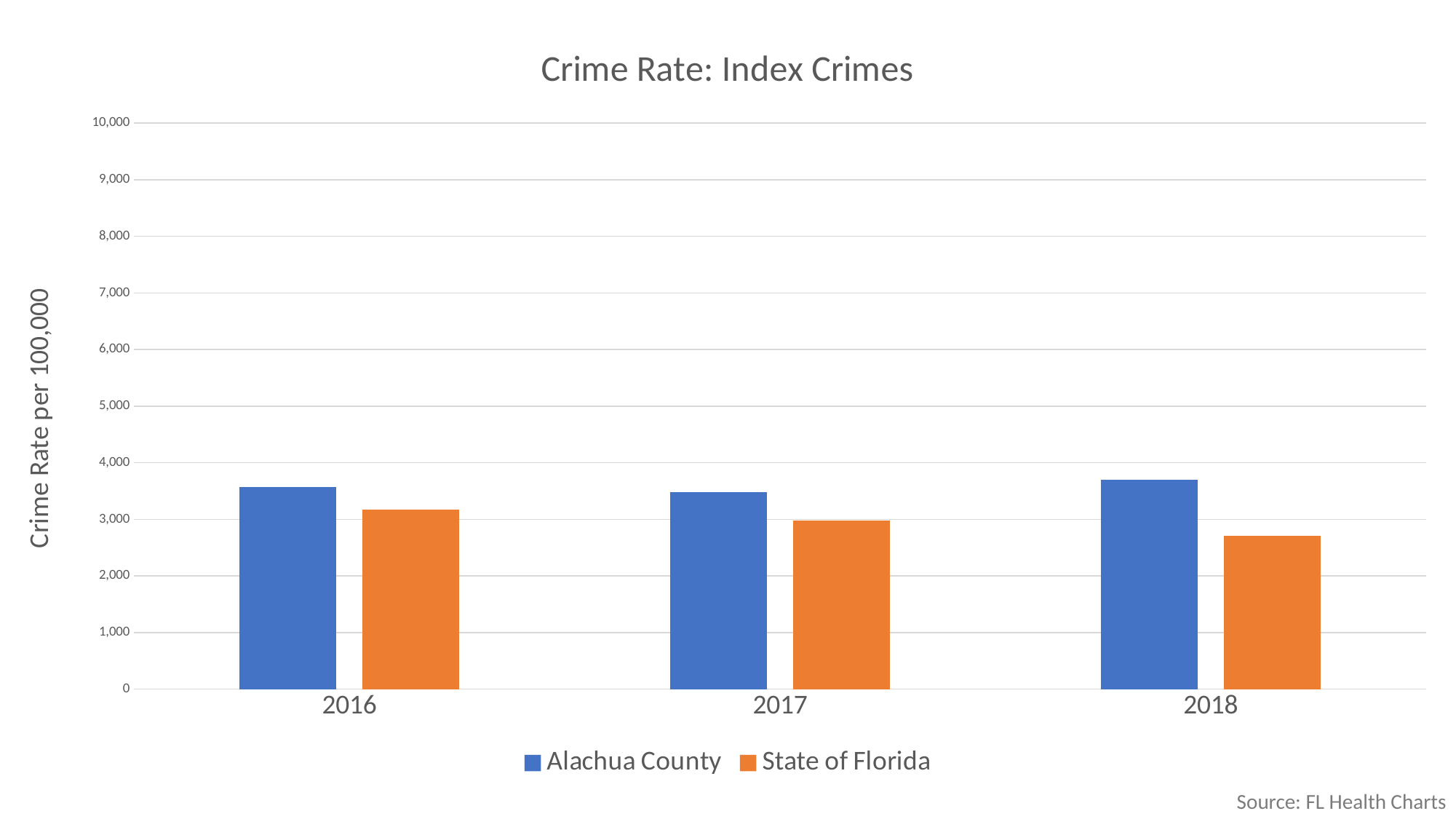
In which year is the State of Florida value lowest? 2018 In 2017, which is larger: Alachua County or State of Florida? Alachua County How many years are shown on the x axis? 3 How many series does the legend list? 2 What is the title of the chart? Crime Rate: Index Crimes What is the label of the vertical axis? Crime Rate per 100,000 Is the value for Alachua County in 2018 greater or less than 4,000? less In which year is the State of Florida value highest? 2016 Is the value for Alachua County in 2016 greater or less than 3,000? greater What type of chart is shown on the slide? bar chart Is the value for State of Florida in 2018 greater or less than 3,000? less Does the State of Florida crime rate rise or fall from 2016 to 2018? fall